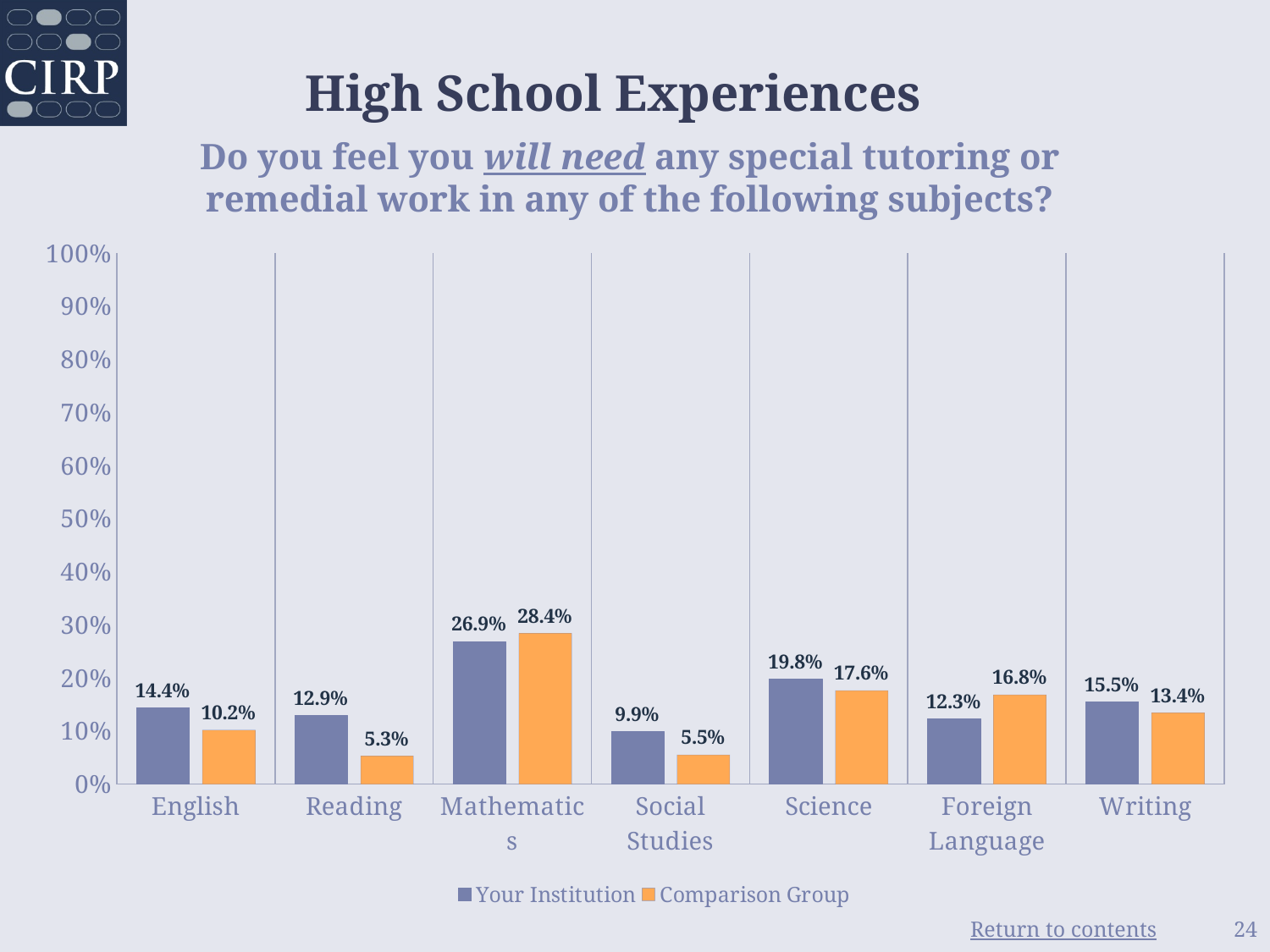
What is the value for Your Institution in Foreign Language? 12.3% How many subjects are shown on the x axis? 7 Which subject has the highest value for Comparison Group? Mathematics What is the difference between Your Institution and Comparison Group for English? 4.2% What kind of chart is shown on the slide? Bar chart How many series does the legend list? 2 What is the difference between Your Institution and Comparison Group for Reading? 7.6% Which subject has the lowest value for Your Institution? Social Studies What is the value for Your Institution in Mathematics? 26.9% What is the value for Comparison Group in Reading? 5.3% Is the value for Comparison Group in Mathematics greater or less than 20%? greater Which is larger for Science: Your Institution or Comparison Group? Your Institution